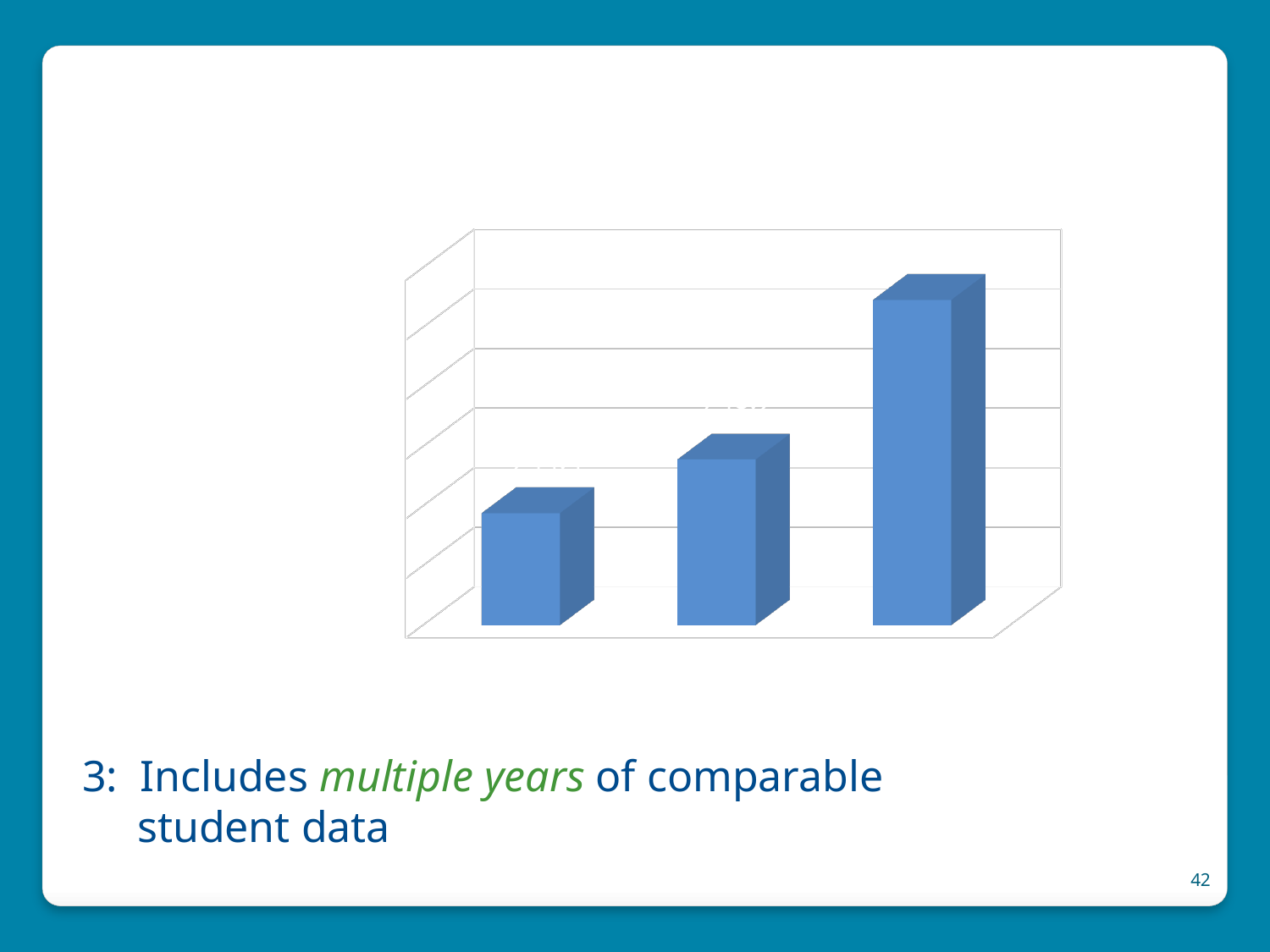
What kind of chart is shown on the slide? bar chart How many bars does the chart show? 3 Do the bar values rise or fall from left to right across the chart? rise Which is larger, the value of the middle bar or the value of the right bar? right bar What colour are the bars in the chart? blue Which is larger, the value of the left bar or the value of the middle bar? middle bar Does the chart display a legend? No Which bar is the shortest: the left, middle, or right bar? left Which bar is the tallest: the left, middle, or right bar? right